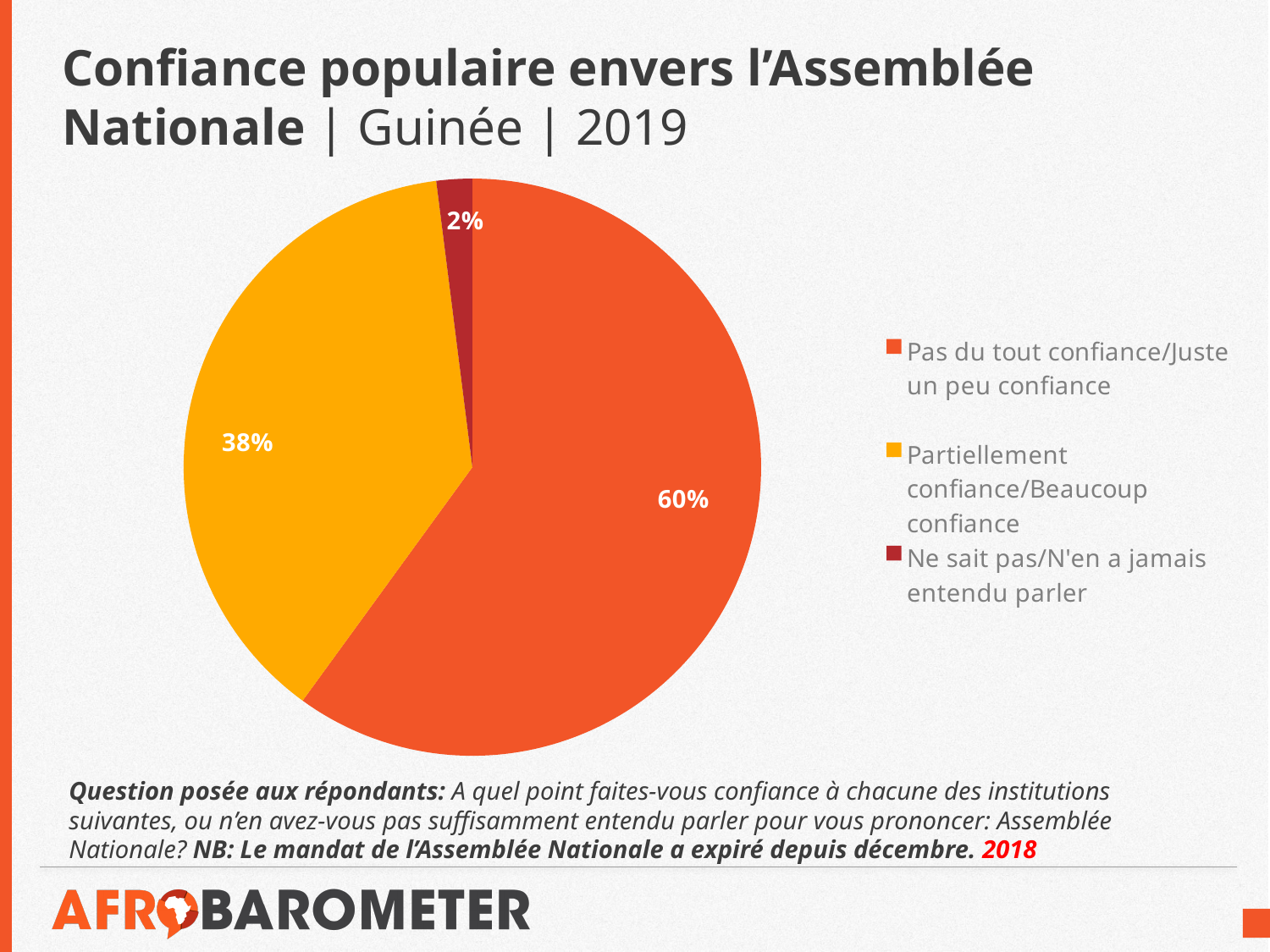
Which response category has the largest slice of the pie? Pas du tout confiance/Juste un peu confiance Which country and year does the chart title refer to? Guinée, 2019 What is the difference in percentage points between "Pas du tout confiance/Juste un peu confiance" and "Partiellement confiance/Beaucoup confiance"? 22 percentage points Which response category has the smallest slice of the pie? Ne sait pas/N'en a jamais entendu parler What share of respondents answered "Partiellement confiance/Beaucoup confiance"? 38% Which is larger: the share for "Partiellement confiance/Beaucoup confiance" or the share for "Ne sait pas/N'en a jamais entendu parler"? Partiellement confiance/Beaucoup confiance What share of respondents answered "Pas du tout confiance/Juste un peu confiance"? 60% What colour is the slice for "Partiellement confiance/Beaucoup confiance"? yellow-orange What share of respondents answered "Ne sait pas/N'en a jamais entendu parler"? 2% How many slices does the pie chart have? 3 What kind of chart is shown on the slide? pie chart How many entries does the legend list? 3